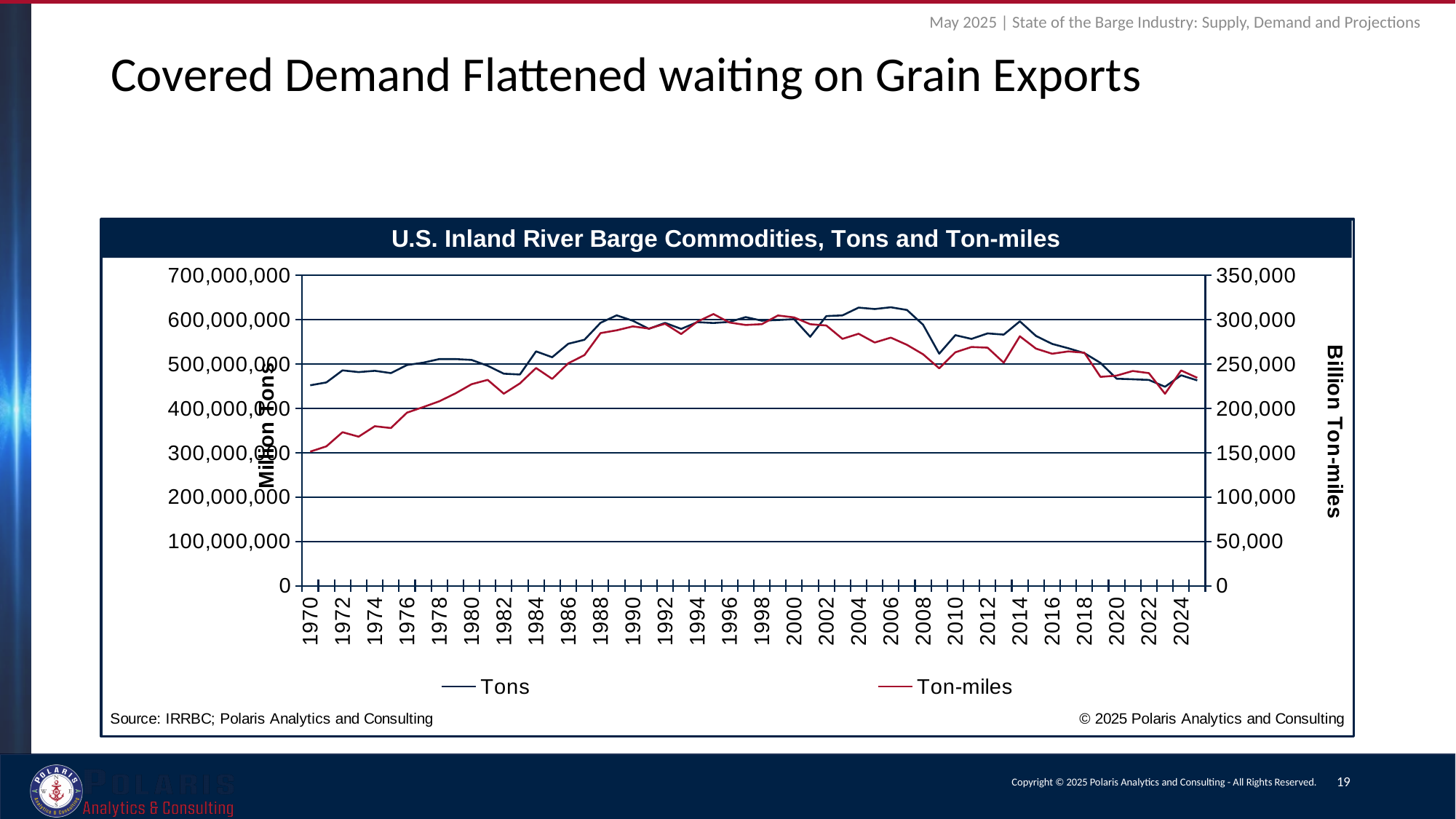
Does the Ton-miles series rise or fall between 1970 and 1990? rise Is the Ton-miles value for 2024 greater or less than 250,000? less Is the Tons value for 2024 greater or less than 500,000,000? less Is the Tons value for 1970 greater or less than 400,000,000? greater How many series does the chart legend list? 2 What kind of chart is shown on the slide? line chart What is the title of the chart? U.S. Inland River Barge Commodities, Tons and Ton-miles Which series is drawn in red in the chart? Ton-miles Does the Tons series rise or fall between 2014 and 2022? fall